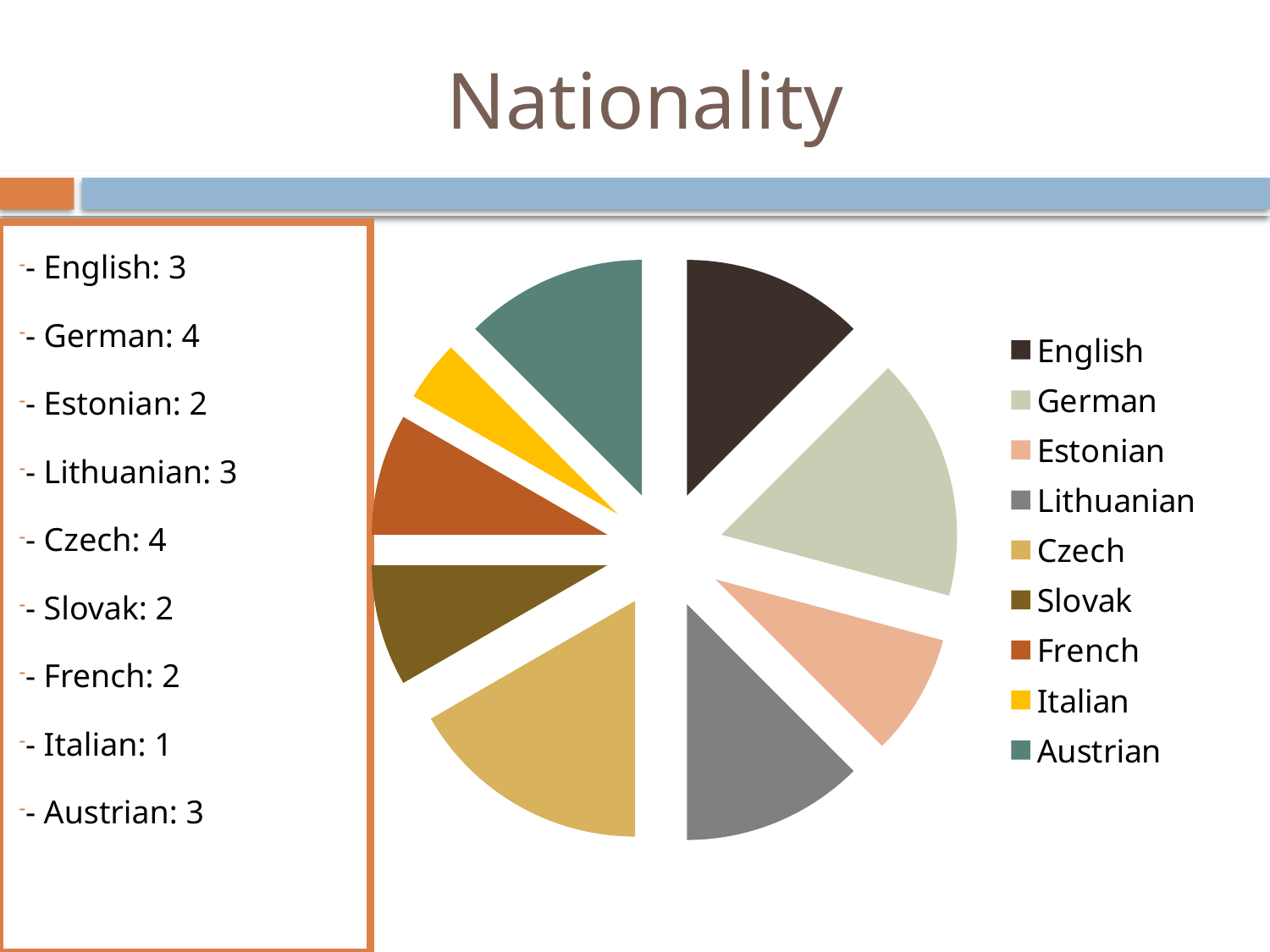
What is the title of the slide containing the pie chart? Nationality What is the value for Italian in the Nationality chart? 1 Which is larger, the value for Czech or the value for Slovak? Czech What is the difference between the value for German and the value for Italian? 3 What is the total of all the values shown in the pie chart? 24 How many entries does the legend of the pie chart list? 9 What is the value for German in the Nationality chart? 4 What kind of chart is shown on the slide? pie chart What is the value for Lithuanian in the Nationality chart? 3 Which is larger, the value for German or the value for Estonian? German How many slices does the pie chart have? 9 Which nationality has the smallest slice in the pie chart? Italian